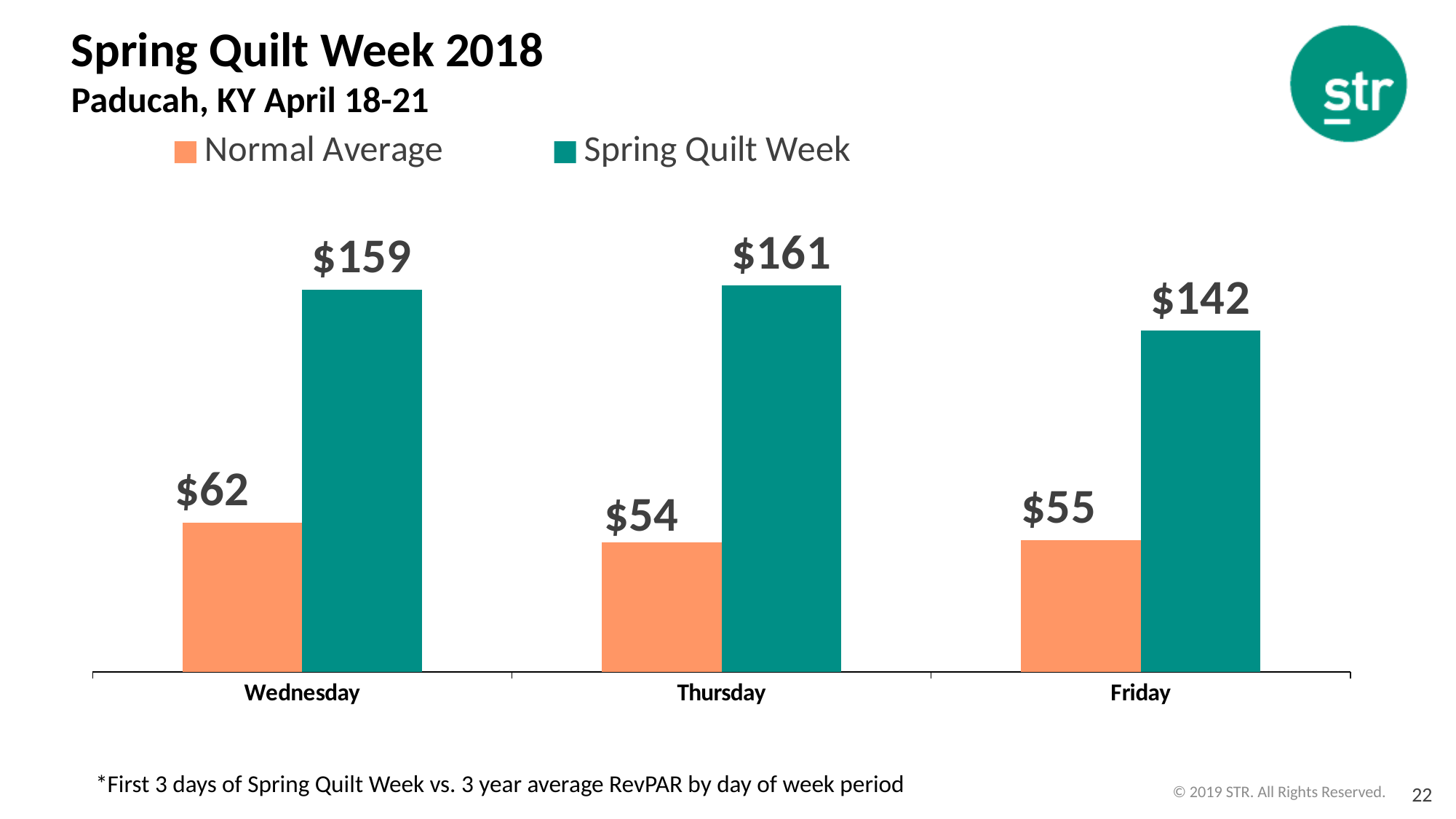
How many series does the legend list? 2 What kind of chart is shown on the slide? Bar chart What is the Spring Quilt Week value for Wednesday? $159 What is the Normal Average value for Friday? $55 Which day has the lowest Normal Average value? Thursday Which is larger, the Normal Average value for Wednesday or for Friday? Wednesday What is the difference between the Spring Quilt Week and Normal Average values for Wednesday? $97 Which day has the highest Spring Quilt Week value? Thursday How many days are shown on the x axis? 3 What is the Spring Quilt Week value for Friday? $142 What is the difference between the Spring Quilt Week values for Thursday and Friday? $19 What is the Normal Average value for Thursday? $54